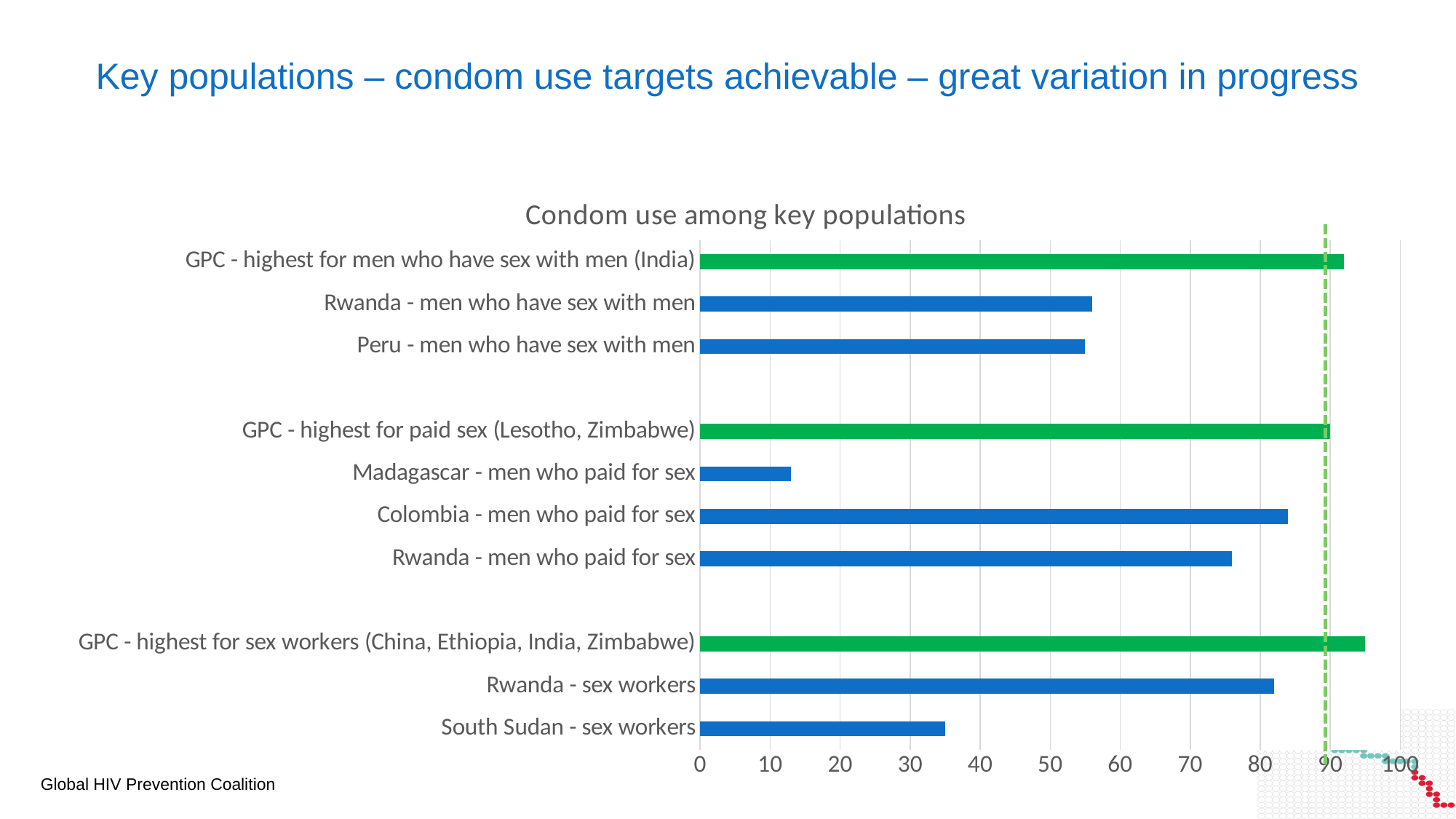
Which is larger, the value for Colombia - men who paid for sex or Rwanda - men who paid for sex? Colombia - men who paid for sex Is the value for GPC - highest for men who have sex with men (India) greater or less than 90? greater What is the title of the chart? Condom use among key populations What kind of chart is shown on the slide? bar chart Is the value for Colombia - men who paid for sex greater or less than 80? greater Is the value for Madagascar - men who paid for sex greater or less than 20? less Which is larger, the value for Rwanda - sex workers or South Sudan - sex workers? Rwanda - sex workers How many bars are plotted in the chart? 10 Which category has the lowest value in the chart? Madagascar - men who paid for sex